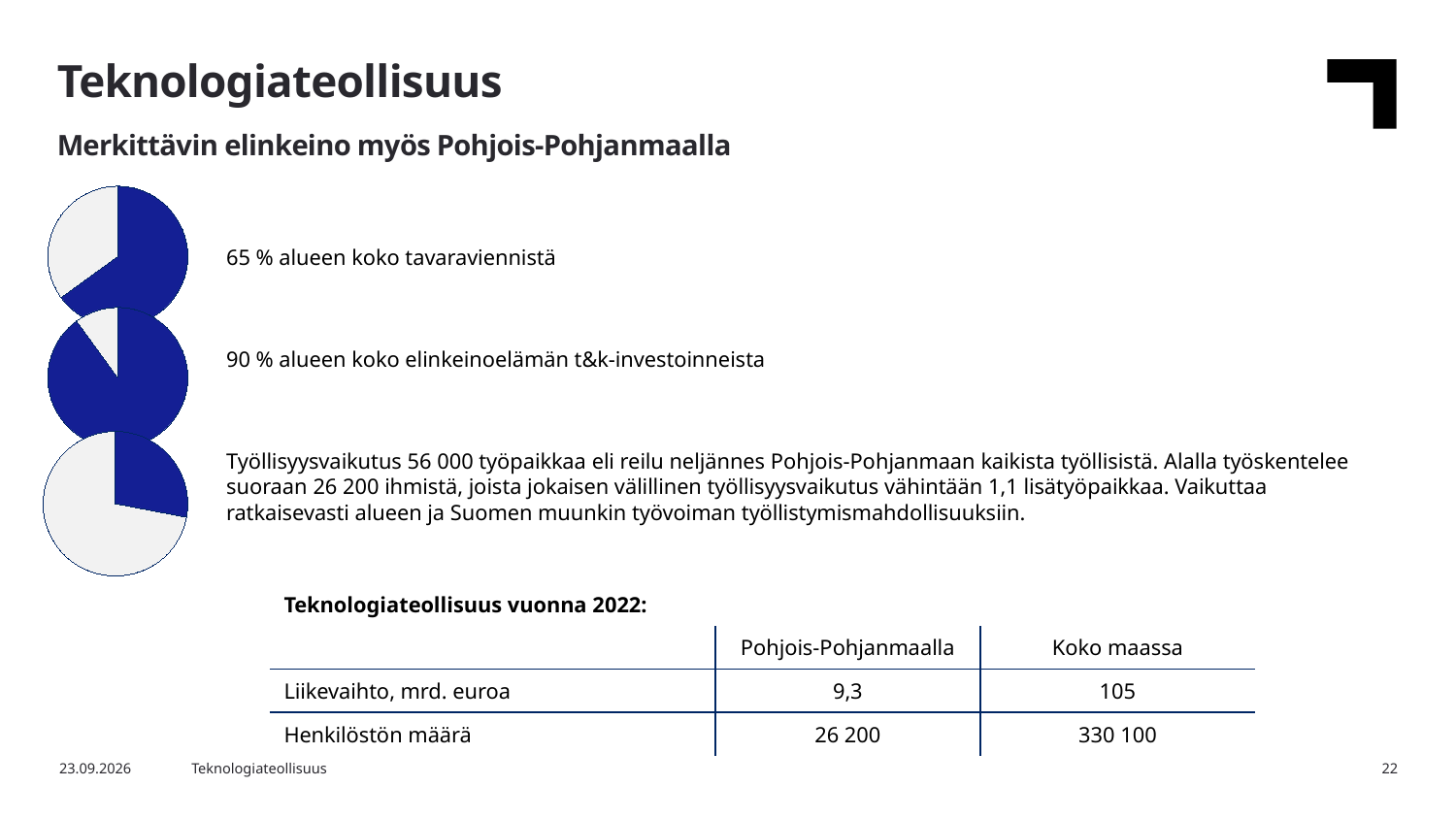
What is the difference between the share shown for t&k-investoinnit (middle pie) and the share shown for tavaravienti (top pie)? 25 percentage points Which pie chart relates to the employment effect (työllisyysvaikutus) of the technology industry: the top, middle or bottom one? Bottom What colour is used for the highlighted slice in the pie charts? Dark blue Is the highlighted share in the top pie chart (tavaravienti) larger or smaller than the highlighted share in the middle pie chart (t&k-investoinnit)? Smaller What kind of charts are shown on the left side of the slide? Pie charts Which pie chart shows the smallest highlighted (blue) share: the top, middle or bottom one? Bottom According to the text next to the middle pie chart, what share of the region's business R&D investments does the technology industry account for? 90 % Which pie chart shows the largest highlighted (blue) share: the top, middle or bottom one? Middle According to the text next to the top pie chart, what share of the region's total goods exports does the technology industry account for? 65 % How many pie charts are on the slide? 3